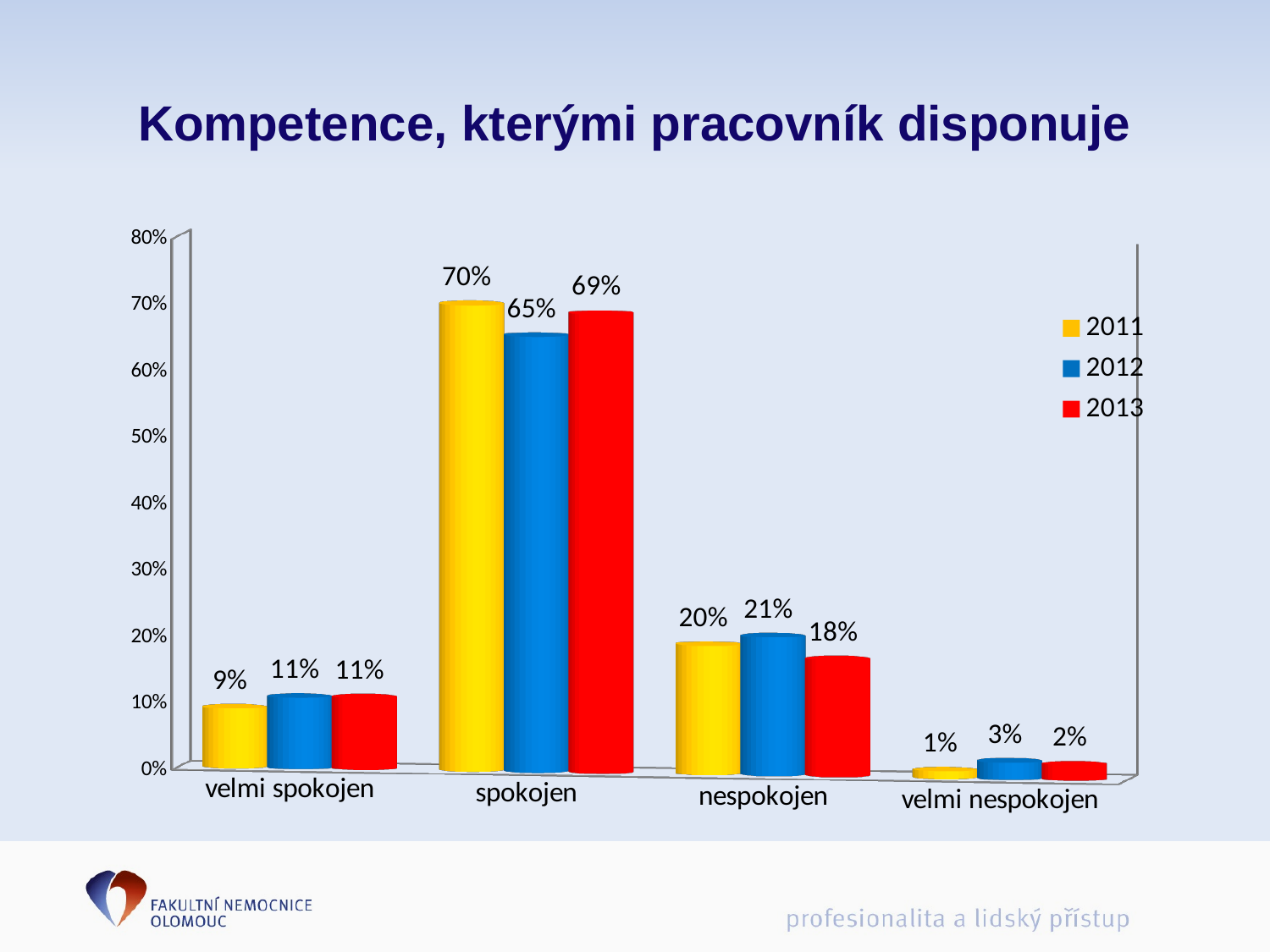
What kind of chart is shown on the slide? bar chart Which category has the highest value for 2012? spokojen How many series does the legend list? 3 What is the value for 2013 in the 'nespokojen' category? 18% How many categories are shown on the x axis? 4 Which category has the lowest value for 2011? velmi nespokojen Is the value for 2013 in the 'spokojen' category greater or less than 60%? greater What is the value for 2011 in the 'spokojen' category? 70% What is the title of the chart? Kompetence, kterými pracovník disponuje Which is larger in the 'nespokojen' category: the 2012 value or the 2013 value? 2012 What is the value for 2012 in the 'velmi nespokojen' category? 3% What is the difference between the 2011 and 2012 values in the 'spokojen' category? 5%